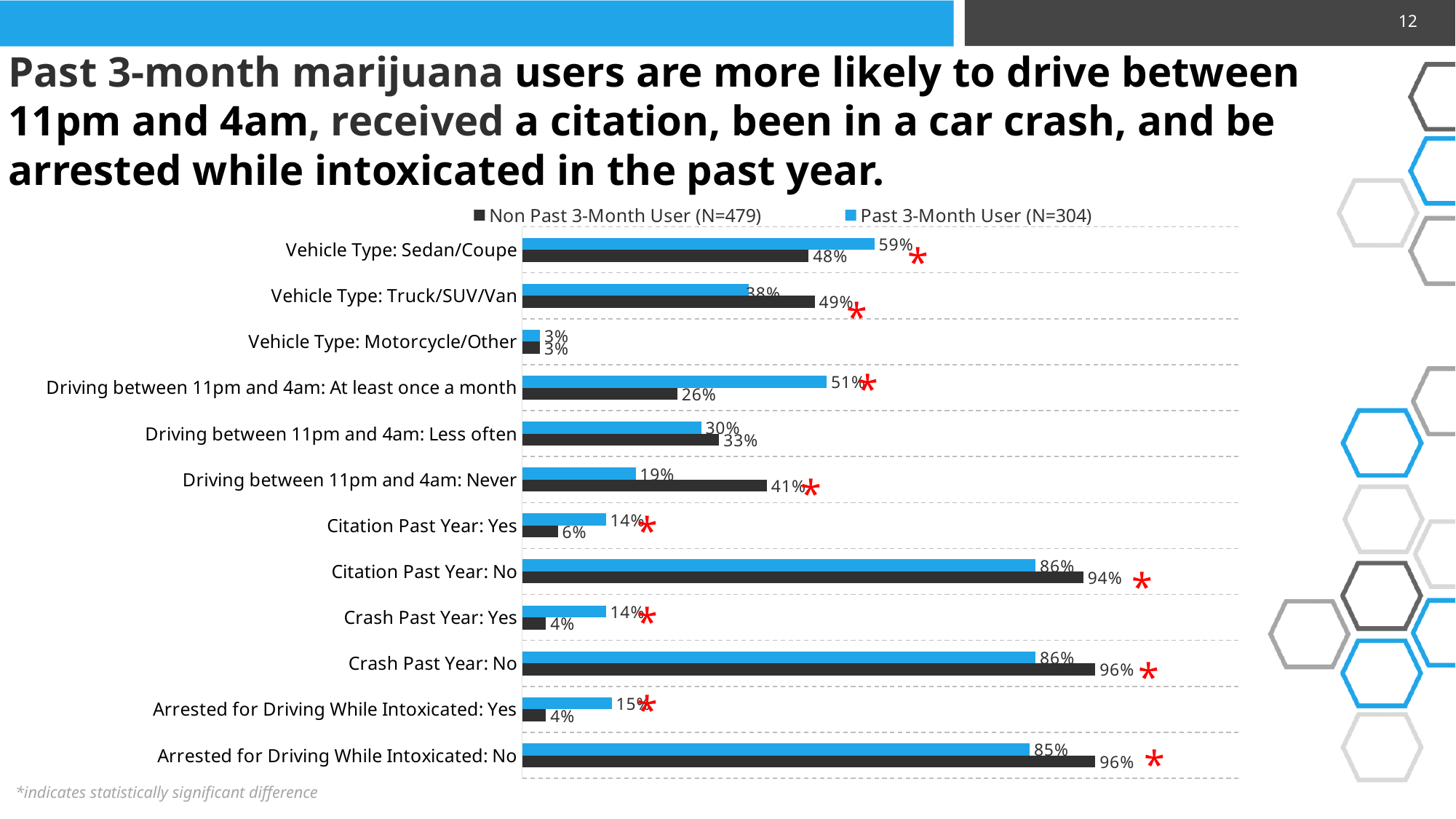
What is the value for Non Past 3-Month Users in the 'Driving between 11pm and 4am: Never' category? 41% How many categories are shown on the chart? 12 What percentage of Past 3-Month Users drive between 11pm and 4am at least once a month? 51% How many series does the legend list? 2 Which category has the lowest value for Past 3-Month Users? Vehicle Type: Motorcycle/Other What percentage of Non Past 3-Month Users received a citation in the past year (Citation Past Year: Yes)? 6% What is the sample size (N) for the Non Past 3-Month User group shown in the legend? 479 What type of chart is shown on the slide? Bar chart Which group has the higher value for 'Vehicle Type: Sedan/Coupe'? Past 3-Month User (N=304) What is the difference between Past 3-Month Users and Non Past 3-Month Users for 'Crash Past Year: Yes'? 10 percentage points What is the value for Past 3-Month Users in the 'Arrested for Driving While Intoxicated: Yes' category? 15% Which category has the highest value for Non Past 3-Month Users? Crash Past Year: No and Arrested for Driving While Intoxicated: No (both 96%)